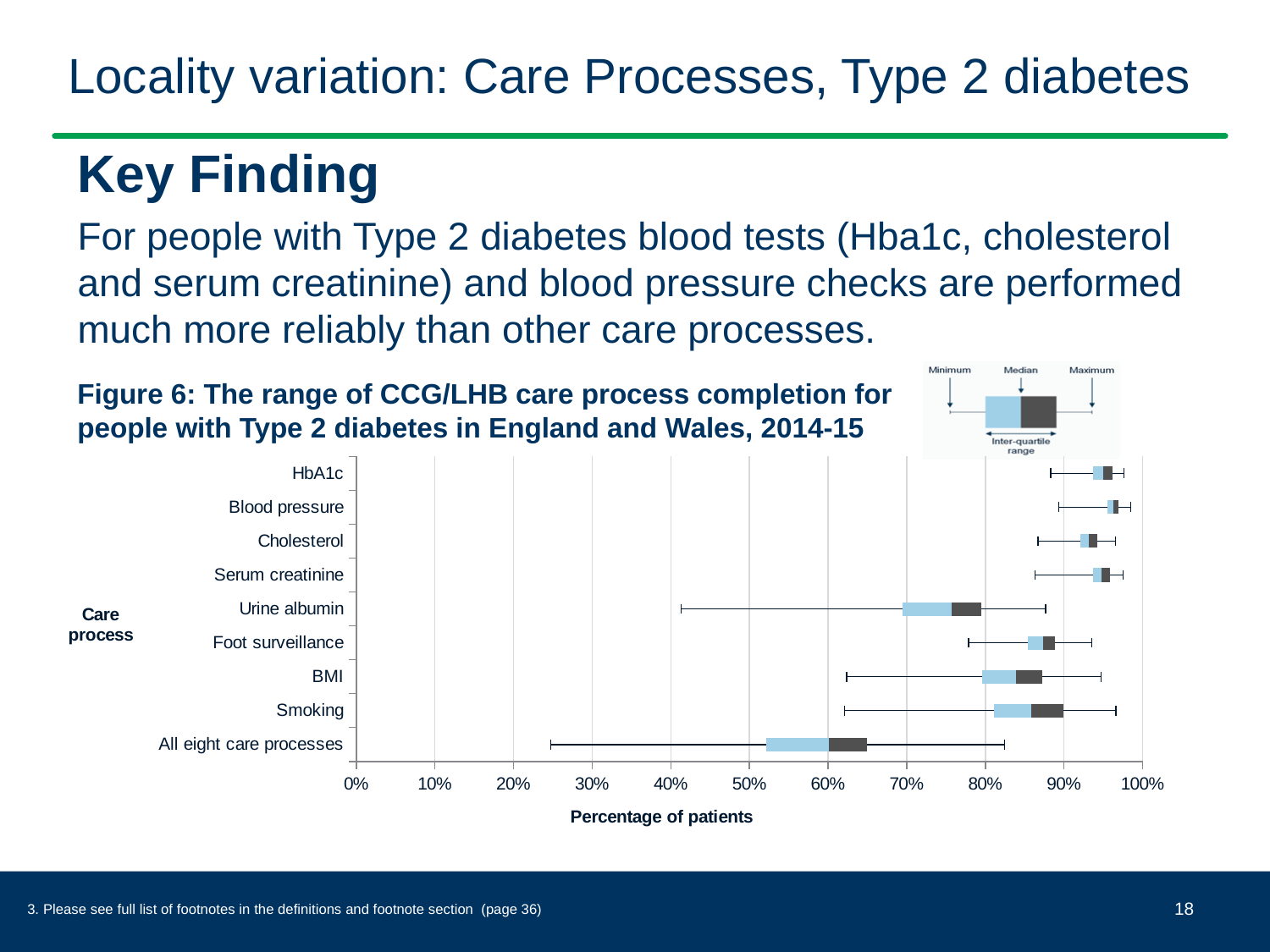
What is the label of the horizontal axis of the chart? Percentage of patients How many care processes are listed on the vertical axis of the chart? 9 Which care process has the lowest median completion percentage? All eight care processes Is the median value for Foot surveillance greater or less than 80%? greater Is the median value for All eight care processes greater or less than 70%? less Which has the higher median completion percentage, Urine albumin or Foot surveillance? Foot surveillance Is the minimum value for All eight care processes greater or less than 30%? less What is the title of the figure shown on the slide? Figure 6: The range of CCG/LHB care process completion for people with Type 2 diabetes in England and Wales, 2014-15 What kind of chart is shown on the slide? Box-and-whisker (box plot) chart